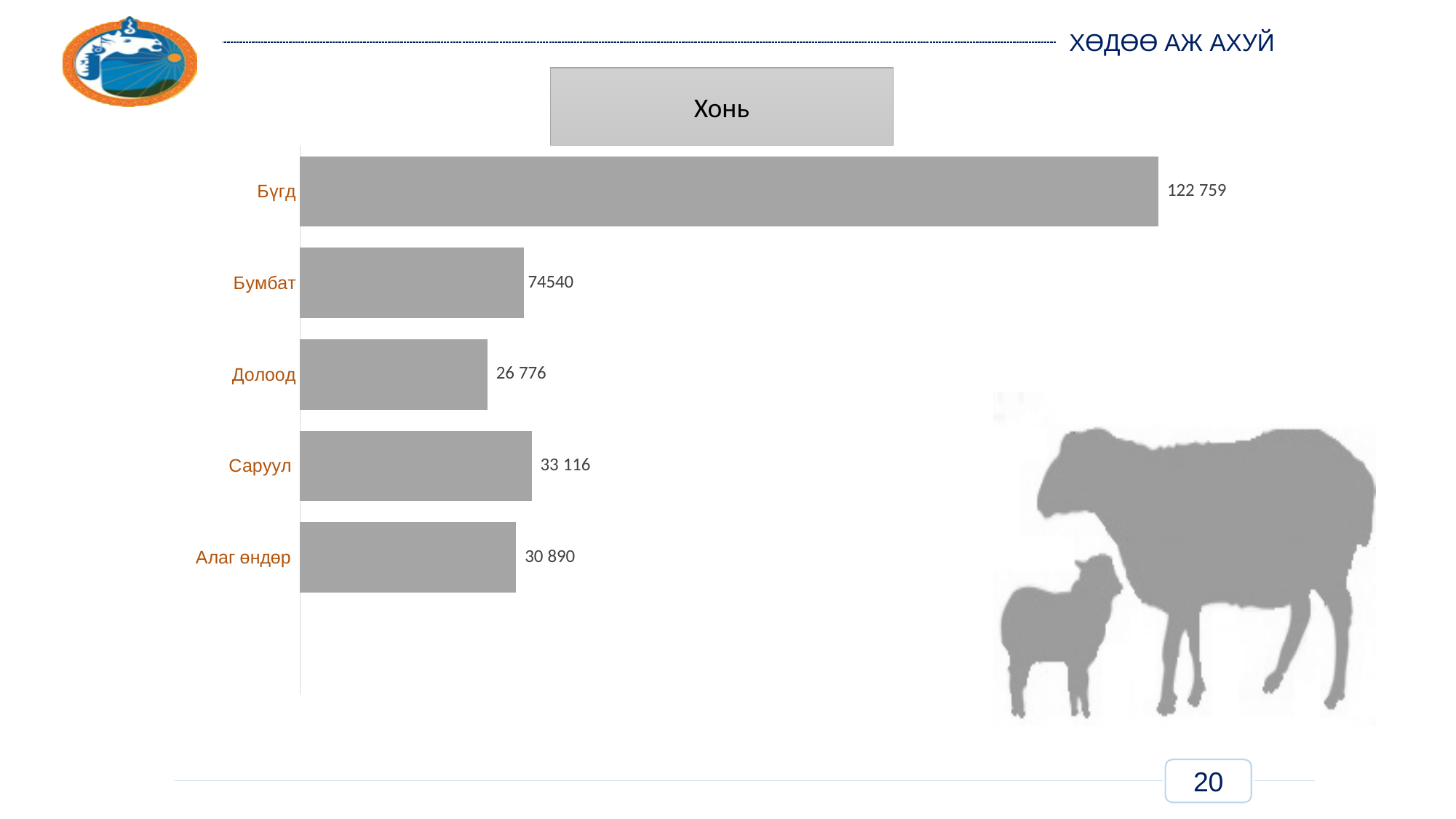
What is the difference between the values for Бумбат and Долоод? 47 764 What is the value for Долоод? 26 776 What is the value for Саруул? 33 116 What is the value for Бүгд? 122 759 Which is larger, the value for Саруул or the value for Алаг өндөр? Саруул How many categories are shown in the chart? 5 Which category has the highest value? Бүгд What is the difference between the values for Саруул and Алаг өндөр? 2 226 What kind of chart is shown on the slide? Bar chart What is the value for Бумбат? 74540 Which category has the lowest value? Долоод What is the value for Алаг өндөр? 30 890